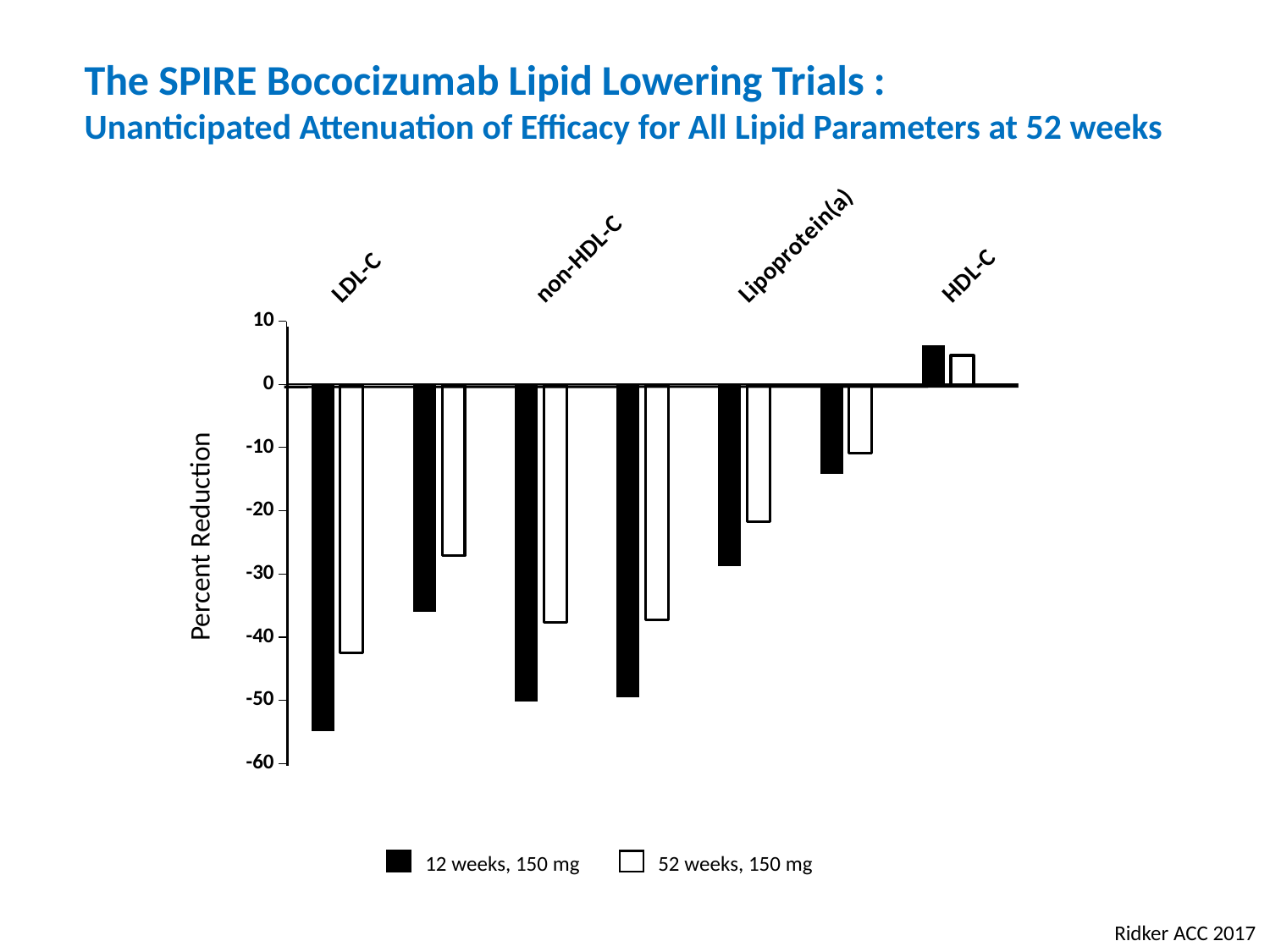
Which lipid parameter is the only one with bars above zero? HDL-C Is the 12 weeks, 150 mg value for HDL-C greater or less than 0? greater What is the label on the vertical axis? Percent Reduction For the lipid parameters with reductions, is the 52 weeks bar shorter or longer than the 12 weeks bar in each pair? shorter Is the 52 weeks, 150 mg value for HDL-C greater or less than 10? less How many lipid parameter categories are labelled along the top of the chart? 4 What kind of chart is shown on the slide? bar chart For HDL-C, which bar is taller: 12 weeks, 150 mg or 52 weeks, 150 mg? 12 weeks, 150 mg How many series does the legend list? 2 Which lipid parameter shows the largest percent reduction at 12 weeks? LDL-C What are the two series named in the legend? 12 weeks, 150 mg and 52 weeks, 150 mg Is the largest 12 weeks, 150 mg value for LDL-C greater or less than -50? less